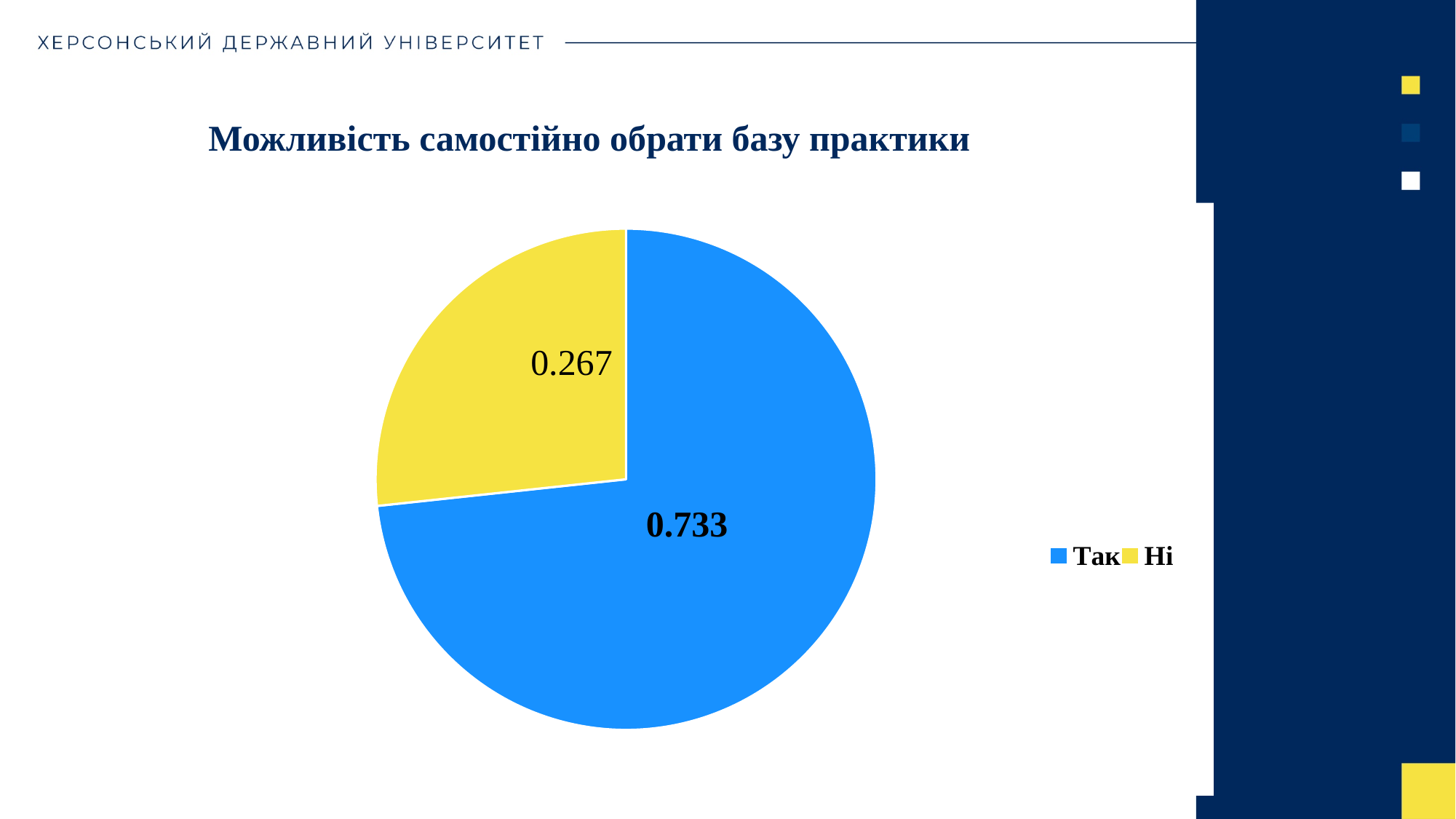
What kind of chart is shown on the slide? Pie chart Which category has the largest slice of the pie? Так What value is shown for the "Ні" slice? 0.267 What is the title of the chart? Можливість самостійно обрати базу практики How many slices does the pie chart have? 2 What colour is the "Ні" slice? Yellow Which is larger, the value for "Так" or the value for "Ні"? Так Which category has the smallest slice of the pie? Ні What is the difference between the values for "Так" and "Ні"? 0.466 How many entries does the legend list? 2 What value is shown for the "Так" slice? 0.733